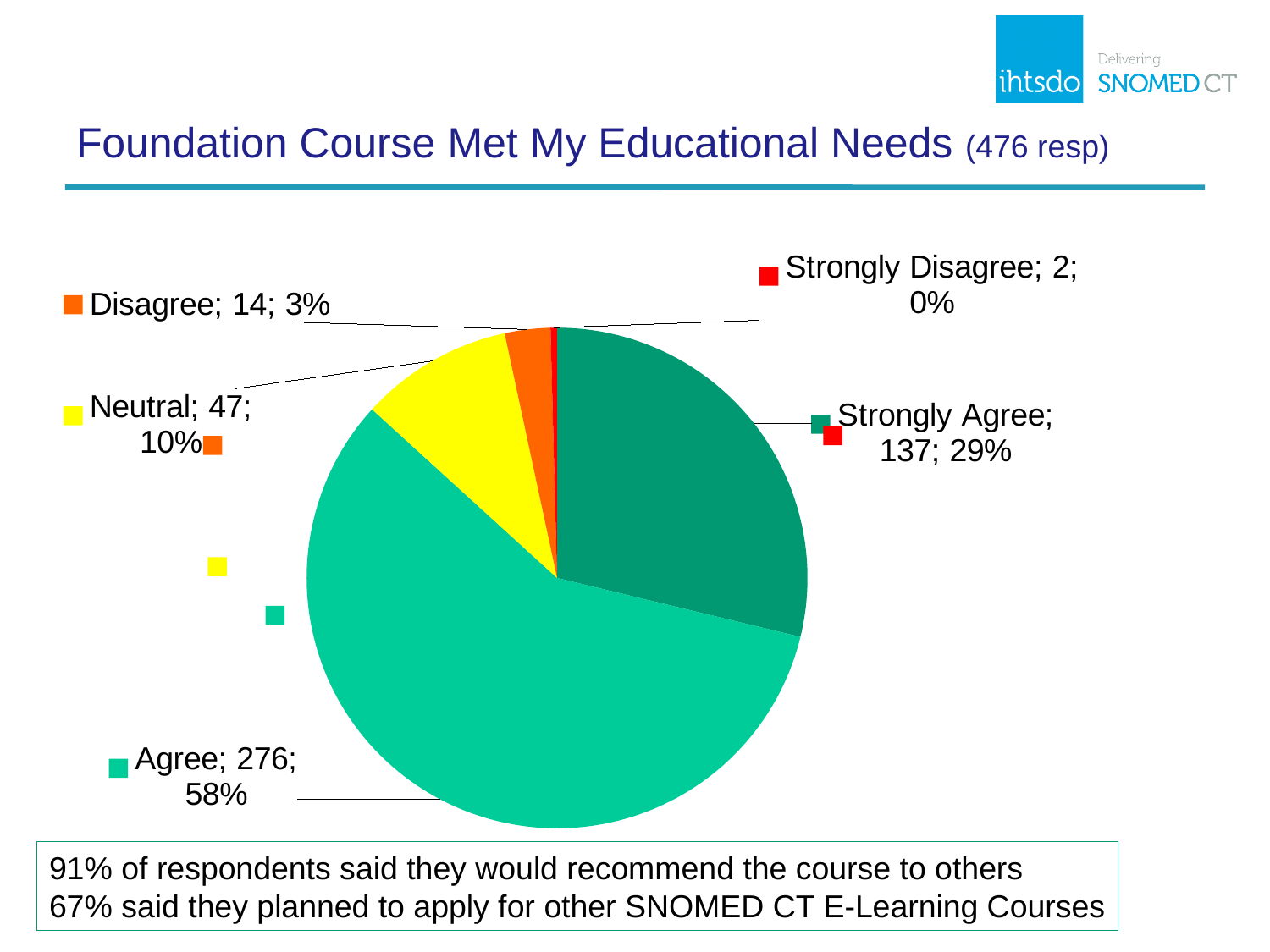
Which response category has the smallest slice of the pie? Strongly Disagree How many respondents answered "Neutral"? 47 Which response category has the largest slice of the pie? Agree How many respondents answered "Agree"? 276 What is the difference between the number of "Agree" and "Strongly Agree" responses? 139 How many response categories are shown in the pie chart? 5 What kind of chart is shown on the slide? pie chart What is the title of the chart on the slide? Foundation Course Met My Educational Needs (476 resp) Which has more responses, "Neutral" or "Disagree"? Neutral How many respondents answered "Strongly Disagree"? 2 What percentage of respondents answered "Disagree"? 3% What percentage of respondents answered "Strongly Agree"? 29%